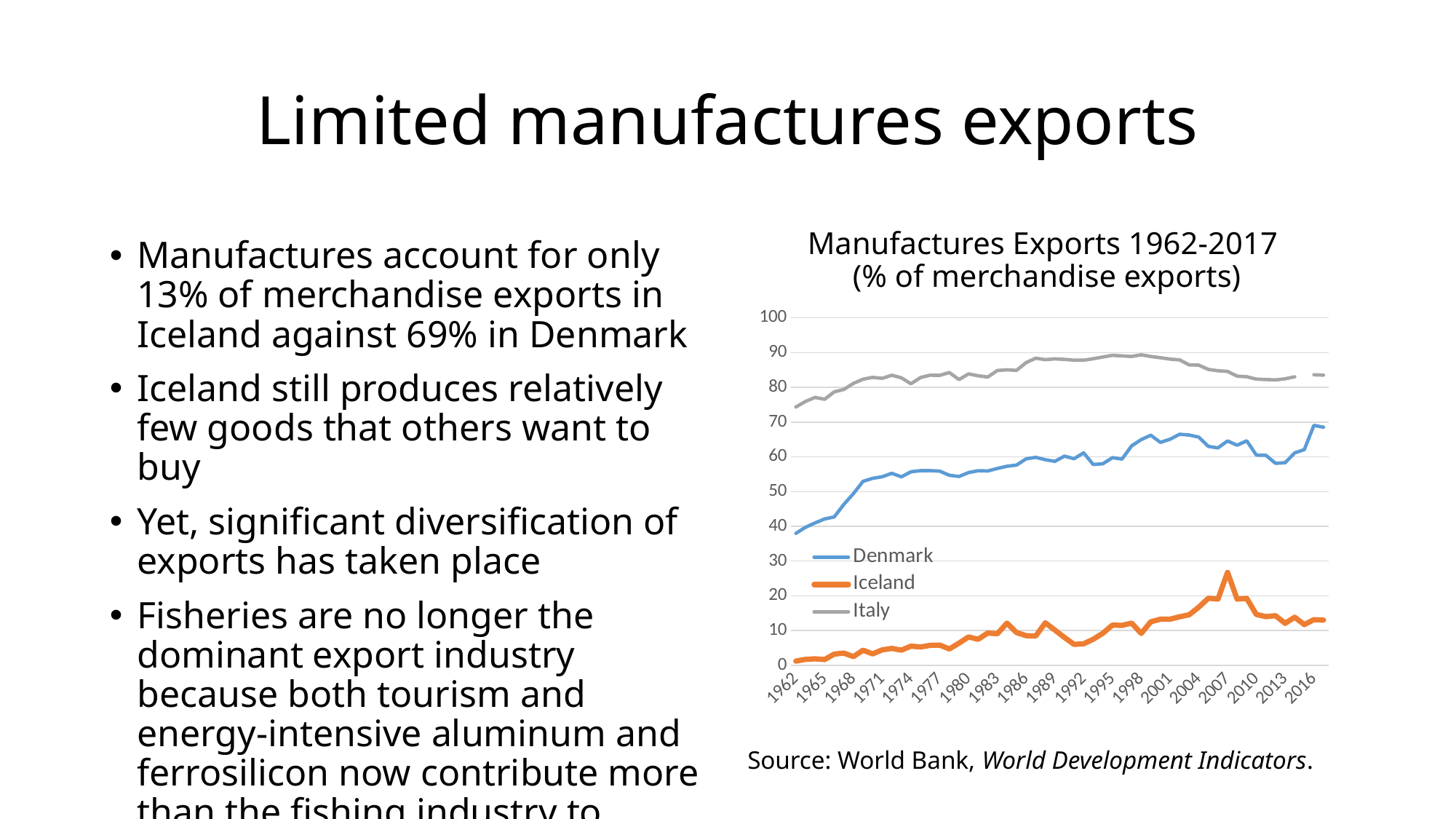
Which countries are listed in the chart's legend? Denmark, Iceland, Italy How many series does the legend of the chart list? 3 Which country has the highest manufactures export share throughout the period shown? Italy What kind of chart is shown on the slide? Line chart Which is larger in 1980, the value for Italy or the value for Denmark? Italy Is the value for Iceland at its 2007 peak greater or less than 20? greater Does the Iceland line generally rise or fall from 1962 to 2016? rise Is the value for Italy in 1962 greater or less than 70? greater Is the value for Denmark in 1962 greater or less than 40? less Which country has the lowest manufactures export share throughout the period shown? Iceland What is the title of the chart? Manufactures Exports 1962-2017 (% of merchandise exports)